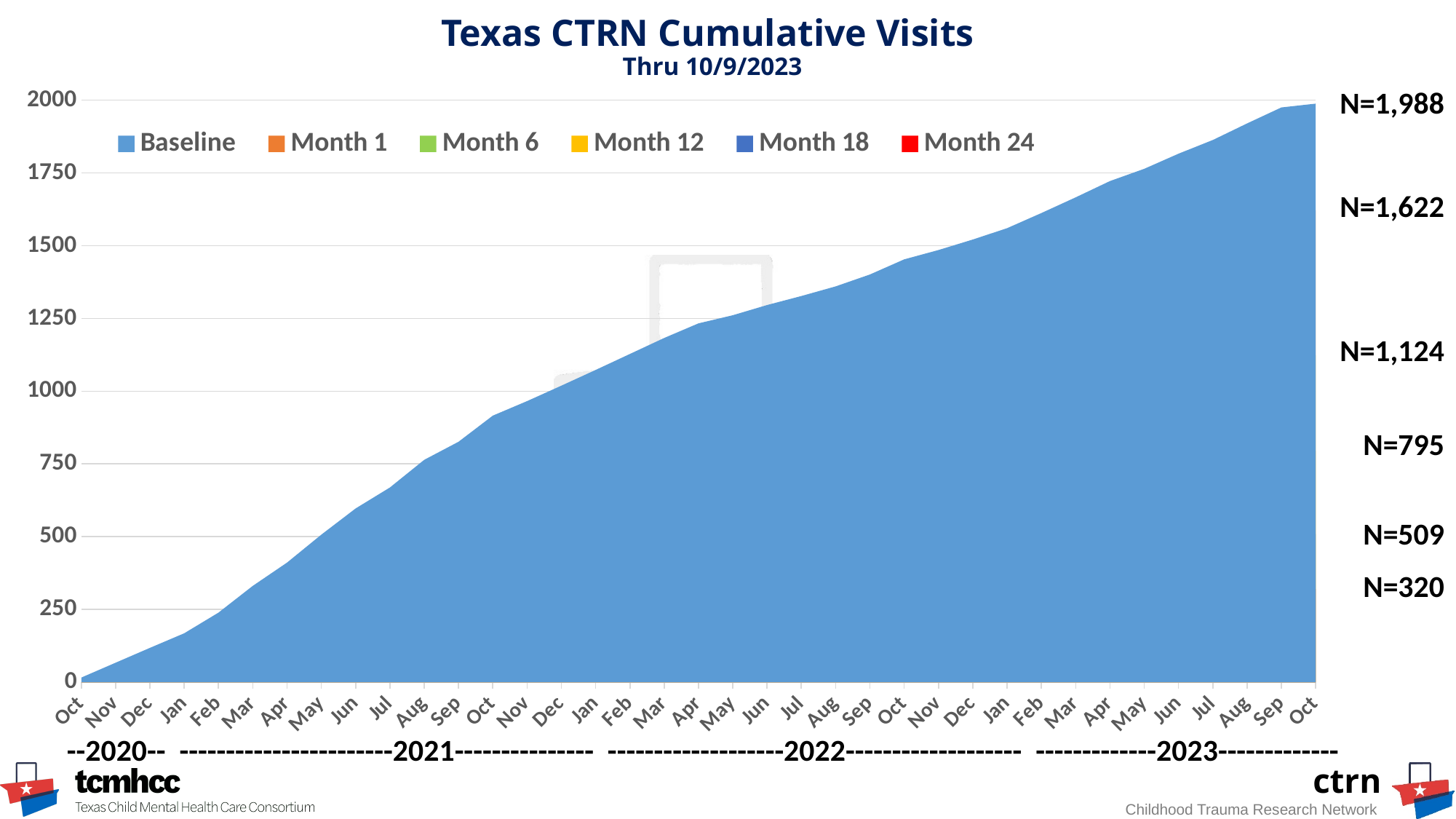
Do the plotted Baseline values rise or fall from Oct 2020 to Oct 2023? Rise Which month on the x axis has the highest Baseline cumulative value? Oct 2023 Is the Baseline value for Apr 2021 greater or less than 500? less Is the Baseline value for Oct 2022 greater or less than 1250? greater Is the Baseline value for Jul 2023 greater or less than 1750? greater What is the largest N value printed on the right side of the chart? N=1,988 How many series does the chart legend list? 6 Is the Baseline value for Jan 2022 larger than the Baseline value for Jan 2021? Yes Which month on the x axis has the lowest Baseline cumulative value? Oct 2020 What kind of chart is shown on the slide? Area chart How many monthly points are labelled along the x axis? 37